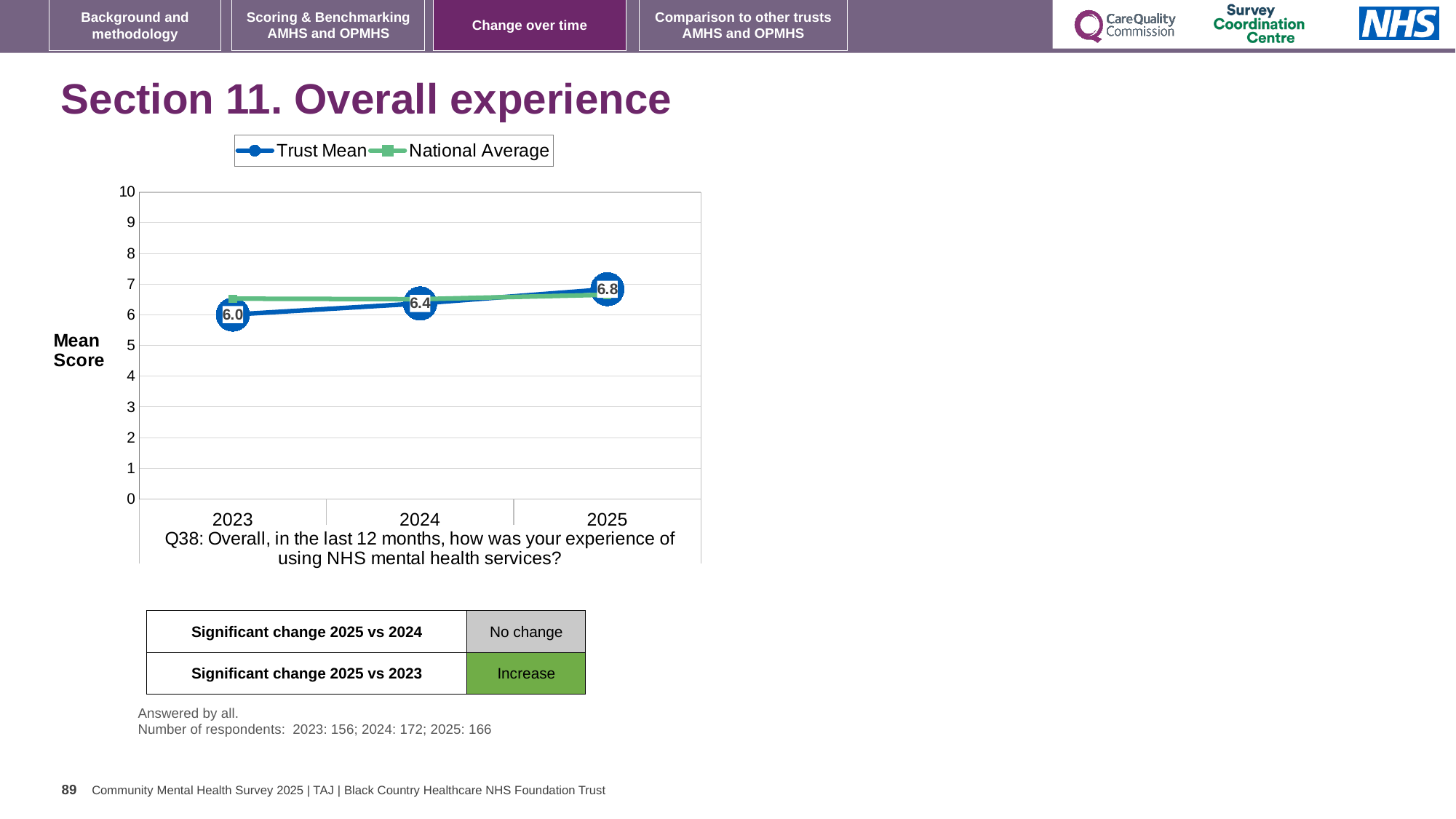
What type of chart is shown on the slide? line chart In 2023, which is higher: the Trust Mean or the National Average? National Average How many series does the legend list? 2 What is the Trust Mean score for 2023? 6.0 Is the National Average value for 2023 greater or less than 6? greater What is the difference between the Trust Mean in 2024 and in 2023? 0.4 By how much did the Trust Mean increase from 2023 to 2025? 0.8 Does the Trust Mean rise or fall from 2023 to 2025? rise What is the Trust Mean score for 2025? 6.8 In which year is the Trust Mean lowest? 2023 In which year is the Trust Mean highest? 2025 What is the Trust Mean score for 2024? 6.4